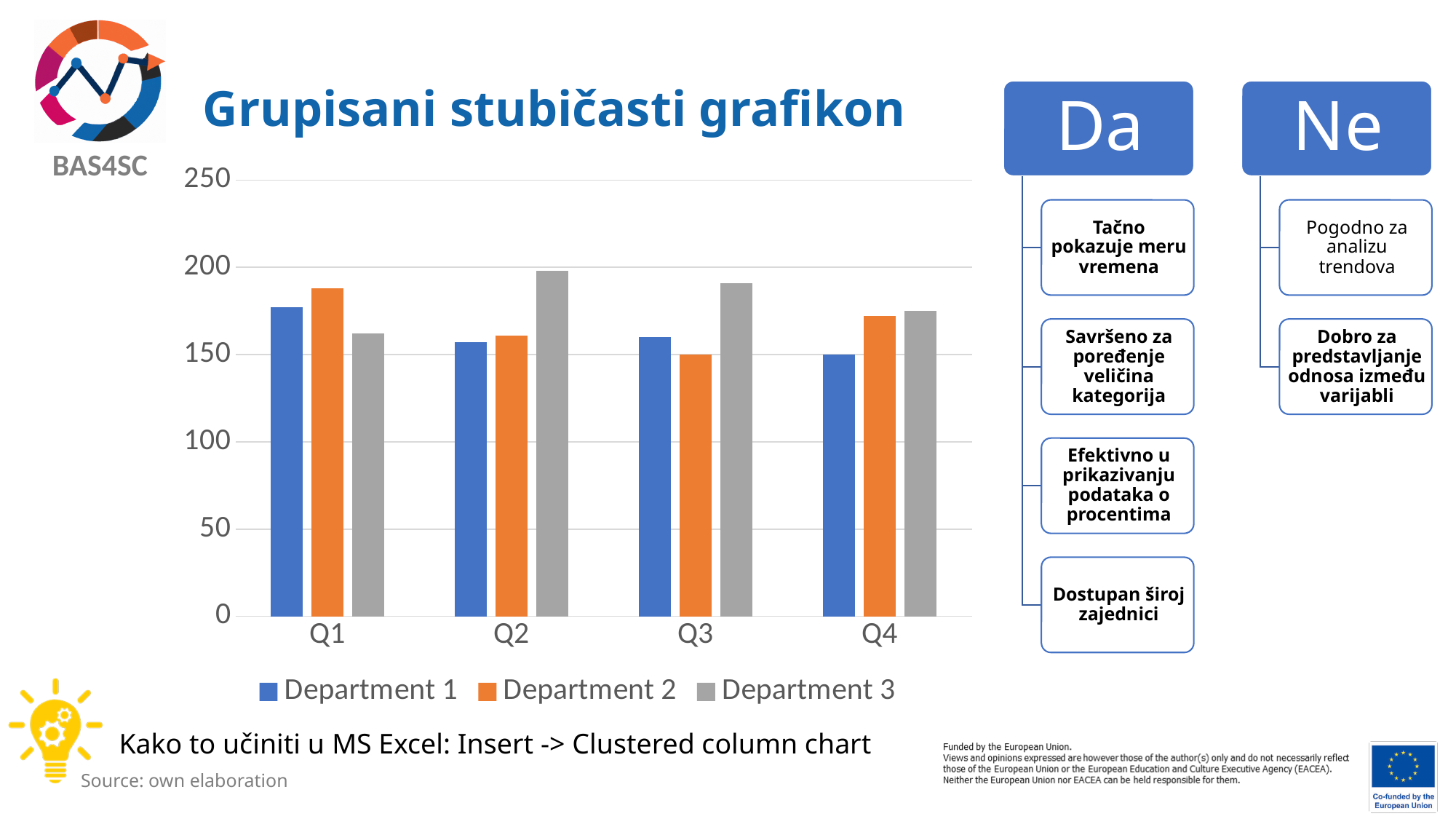
Which department has the highest bar in Q2? Department 3 Which department has the lowest bar in Q3? Department 2 How many series does the chart legend list? 3 Is the value for Department 2 in Q1 greater or less than 200? less In Q1, which is larger: Department 1 or Department 3? Department 1 Which department has the lowest bar in Q4? Department 1 What kind of chart is shown on the slide? bar chart Which colour represents Department 2 in the chart legend? orange Is the value for Department 3 in Q2 greater or less than 150? greater How many categories are shown on the x axis of the chart? 4 Which department has the highest bar in Q1? Department 2 What is the title of the slide containing the chart? Grupisani stubičasti grafikon